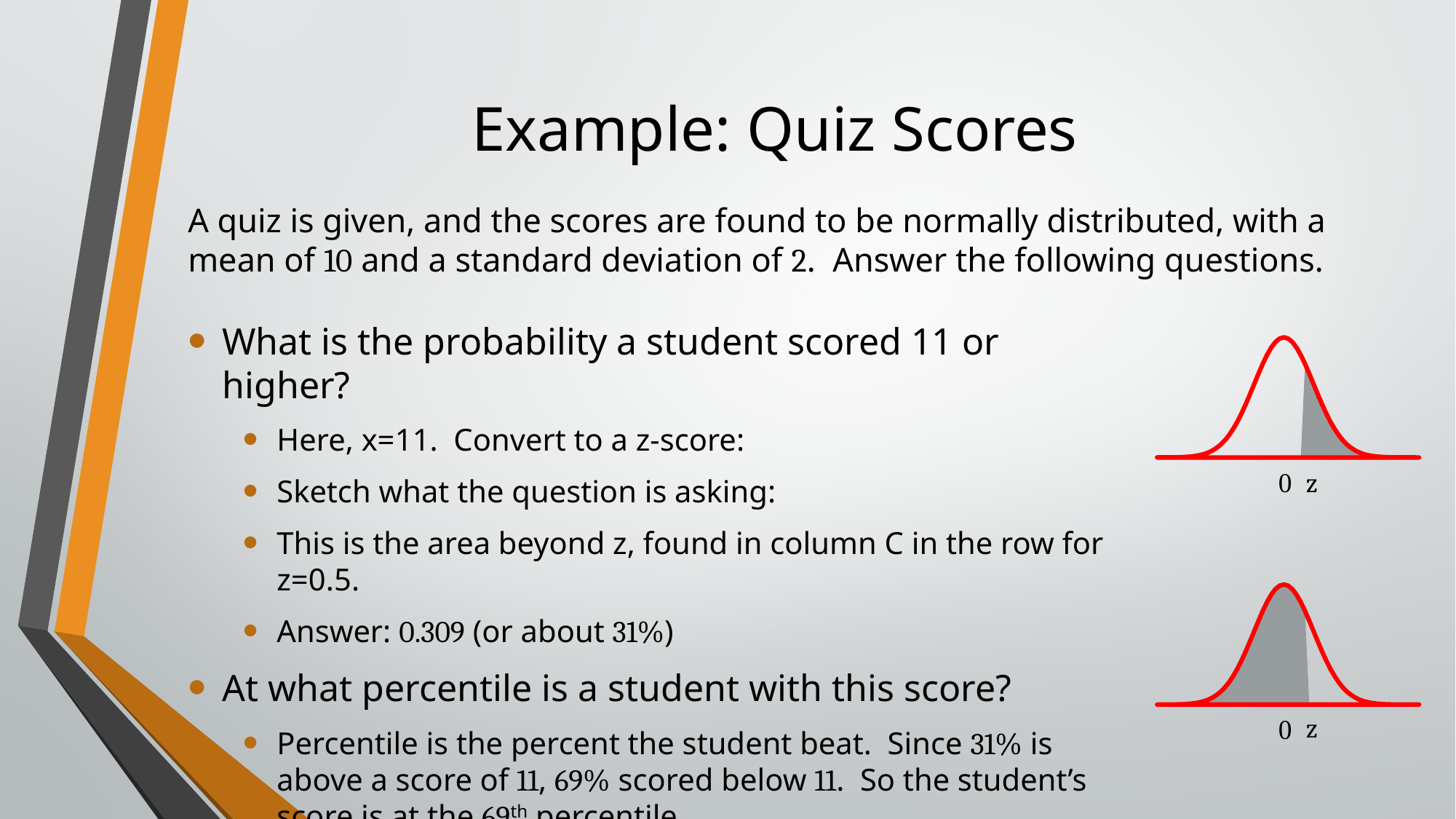
How many normal curve sketches are shown on the slide? 2 In the bottom sketch, is the shaded area to the left or to the right of z? To the left of z In the top sketch, is the shaded area to the left or to the right of z? To the right of z What two labels appear on the horizontal axis of each sketch? 0 and z What kind of chart is shown in the top sketch on the right of the slide? A normal distribution curve